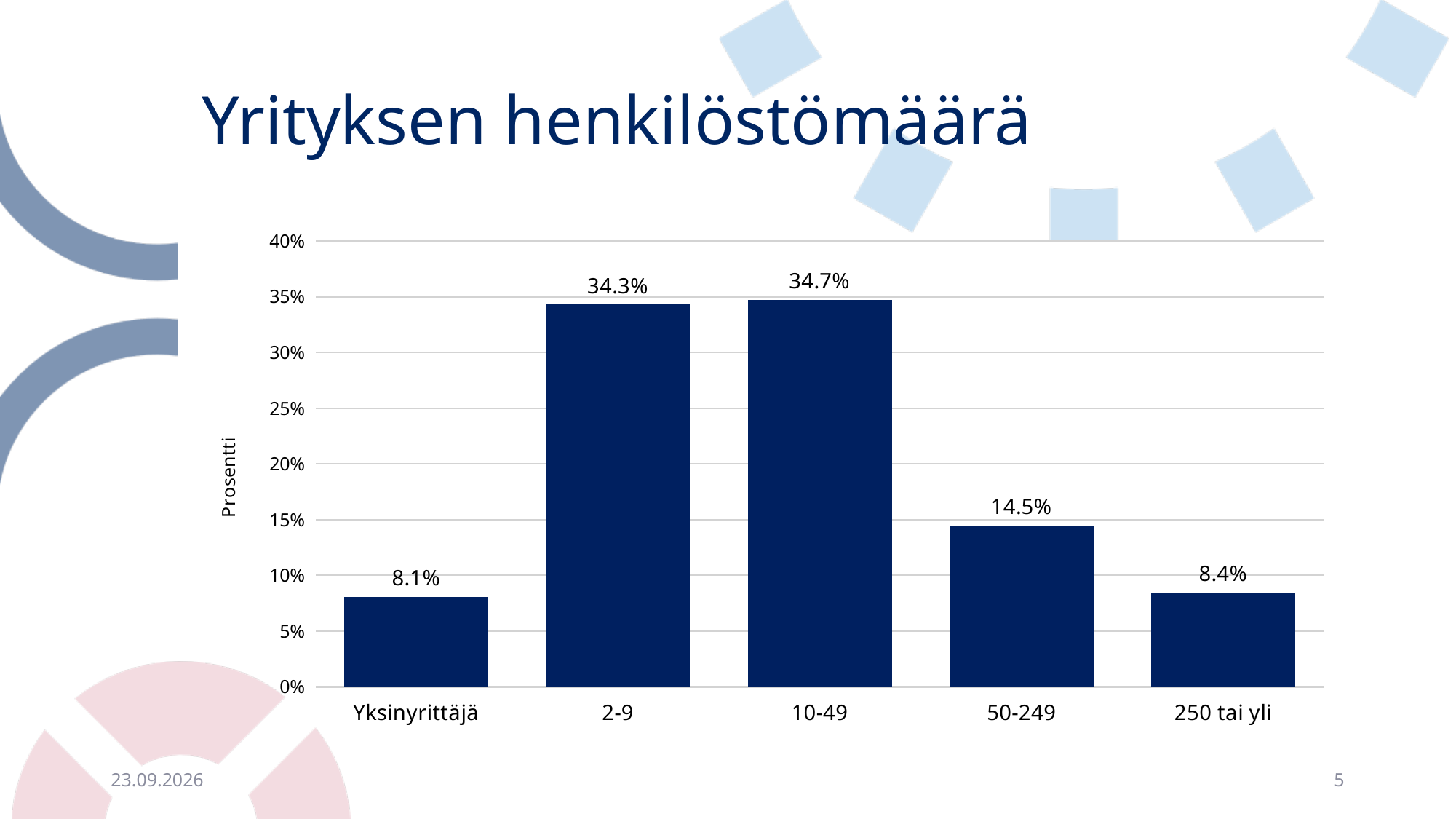
Which category has the lowest value? Yksinyrittäjä How many categories are shown on the x axis? 5 What is the difference between the values for 250 tai yli and Yksinyrittäjä? 0.3% What kind of chart is shown on the slide? bar chart Which category has the highest value? 10-49 What is the value for the 2-9 category? 34.3% What is the difference between the values for 10-49 and 50-249? 20.2% Which is larger, the value for 50-249 or the value for 250 tai yli? 50-249 What is the value for Yksinyrittäjä? 8.1% Is the value for 50-249 greater or less than 10%? greater What is the value for the 250 tai yli category? 8.4% What is the label of the vertical axis? Prosentti